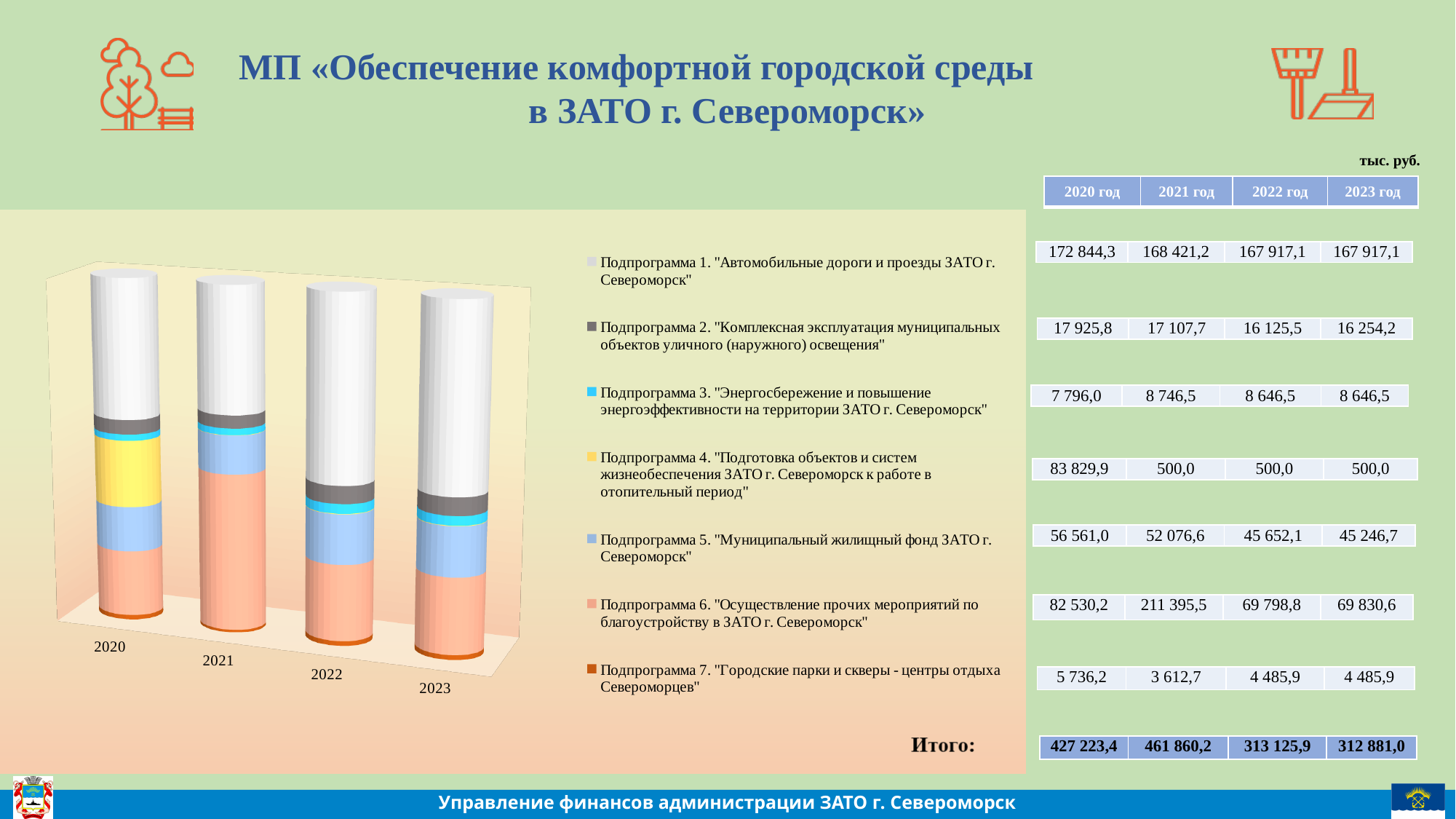
Which year has the lowest total (Итого) across all subprograms? 2023 год What is the value for Подпрограмма 1 "Автомобильные дороги и проезды ЗАТО г. Североморск" in 2020 год? 172 844,3 By how much does the value for Подпрограмма 4 in 2020 год exceed its value in 2021 год? 83 329,9 What is the value for Подпрограмма 7 "Городские парки и скверы" in 2022 год? 4 485,9 What kind of chart is shown on the slide? Stacked bar chart What is the total (Итого) of the stacked bar for 2021 год? 461 860,2 Which year has the highest total (Итого) across all subprograms? 2021 год How many years (categories) are plotted along the x axis of the chart? 4 Which is larger for Подпрограмма 5 "Муниципальный жилищный фонд": the value in 2020 год or in 2021 год? 2020 год How many subprograms (series) does the chart legend list? 7 What is the value for Подпрограмма 6 "Осуществление прочих мероприятий по благоустройству" in 2021 год? 211 395,5 What colour represents Подпрограмма 4 "Подготовка объектов и систем жизнеобеспечения" in the chart legend? Yellow